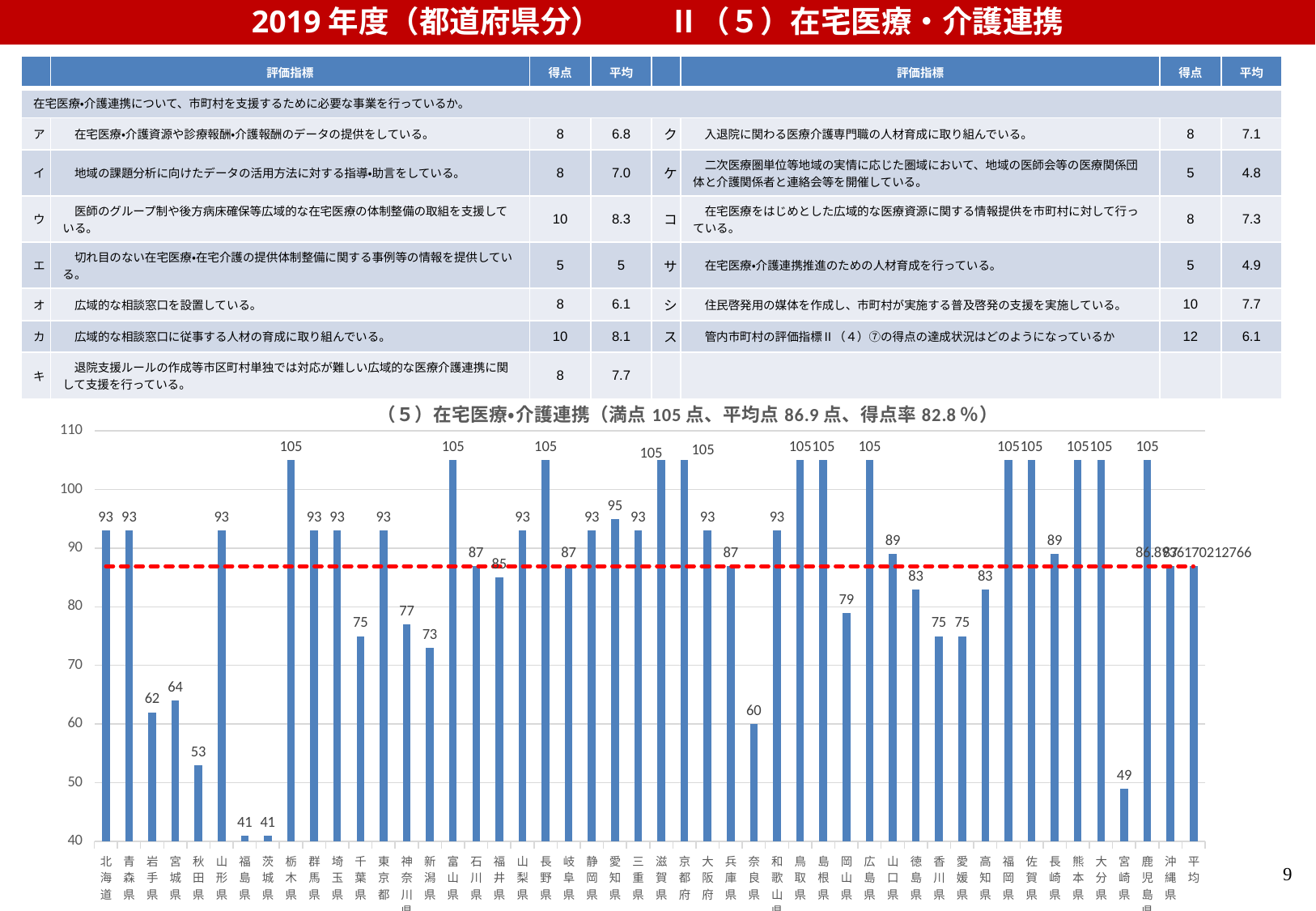
What is the value for 栃木県 in the bar chart? 105 Which has the larger value, 千葉県 or 神奈川県? 神奈川県 What is the difference between the values for 栃木県 and 福島県? 64 What is the value for 宮崎県 in the bar chart? 49 What is the value for 奈良県 in the bar chart? 60 What is the difference between the values for 宮城県 and 岩手県? 2 Is the value for 岡山県 greater or less than 80? less According to the chart title, what is the 平均点 (average score)? 86.9点 What kind of chart is shown on the slide? bar chart What is the value for 愛知県 in the bar chart? 95 What is the value for 秋田県 in the bar chart? 53 Which has the larger value, 秋田県 or 奈良県? 奈良県